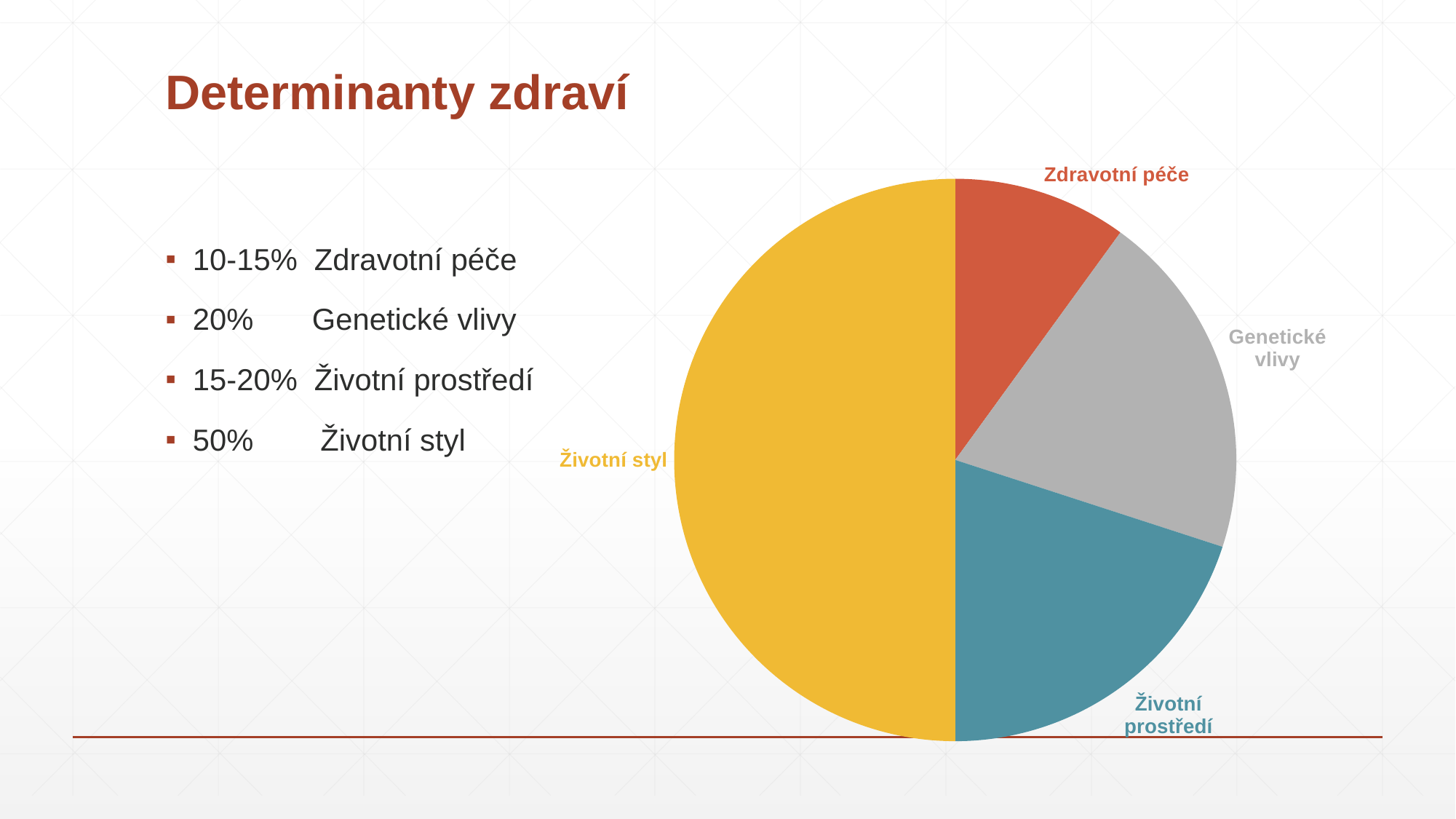
Which slice of the pie chart is the largest? Životní styl What is the title of the slide containing the pie chart? Determinanty zdraví According to the slide, what share does Životní styl have? 50% According to the slide, what share does Genetické vlivy have? 20% According to the slide, what share does Zdravotní péče have? 10-15% Which slice of the pie chart is the smallest? Zdravotní péče How many slices does the pie chart have? 4 Which slice is larger, Genetické vlivy or Zdravotní péče? Genetické vlivy According to the slide, what share does Životní prostředí have? 15-20% Which slice is larger, Životní styl or Životní prostředí? Životní styl What kind of chart is shown on the slide? pie chart What colour is the Životní styl slice in the pie chart? yellow